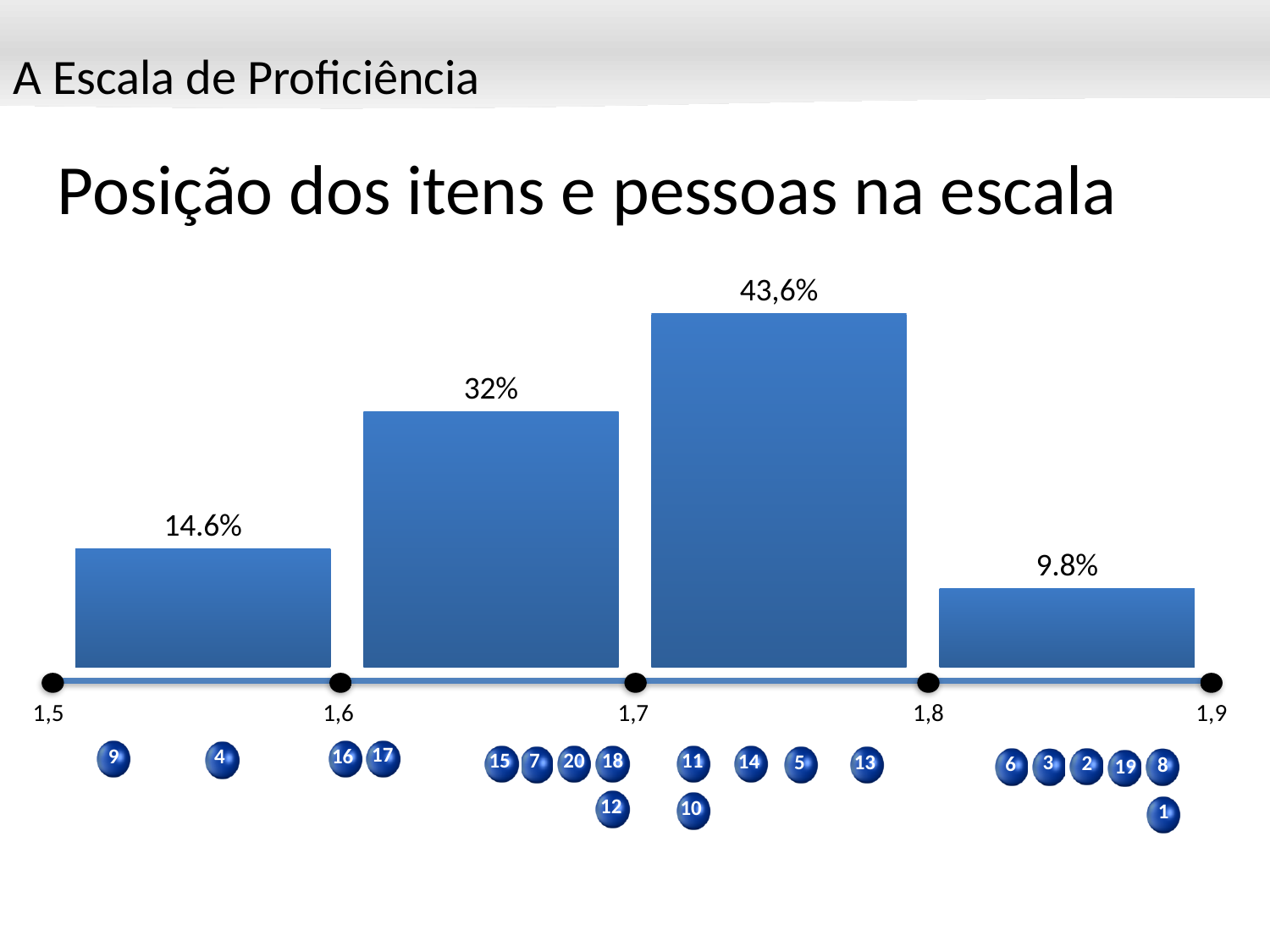
What is the value of the bar between 1,5 and 1,6 on the scale? 14.6% Which interval on the scale has the lowest bar? 1,8 to 1,9 How many bars does the chart have? 4 Do the bar values rise or fall from the 1,7–1,8 interval to the 1,8–1,9 interval? fall Which is larger: the bar between 1,5 and 1,6 or the bar between 1,6 and 1,7? the bar between 1,6 and 1,7 Which interval on the scale has the highest bar? 1,7 to 1,8 What is the value of the bar between 1,7 and 1,8 on the scale? 43,6% What kind of chart is shown on the slide? bar chart What is the value of the bar between 1,8 and 1,9 on the scale? 9.8% What is the difference between the bar between 1,5 and 1,6 and the bar between 1,8 and 1,9? 4.8% What is the value of the bar between 1,6 and 1,7 on the scale? 32% What is the title of the chart on the slide? Posição dos itens e pessoas na escala